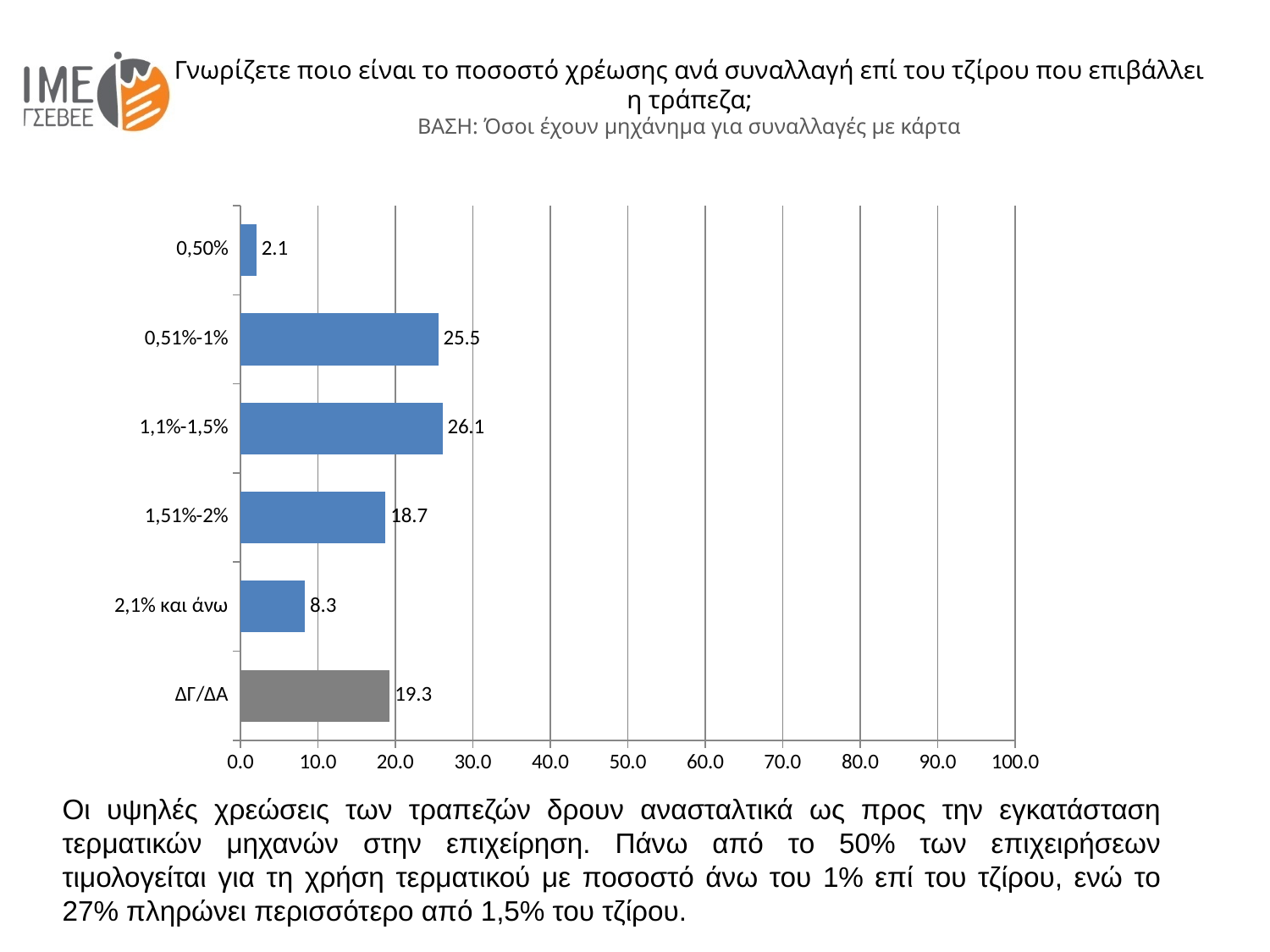
What is the value for the category "ΔΓ/ΔΑ"? 19.3 How many categories are shown in the chart? 6 Which category has the lowest value? 0,50% What is the difference between the values for "1,1%-1,5%" and "1,51%-2%"? 7.4 What is the value for the category "0,51%-1%"? 25.5 What is the maximum value shown on the horizontal axis? 100.0 What kind of chart is shown on the slide? Bar chart Which category has the highest value? 1,1%-1,5% What is the value for the category "2,1% και άνω"? 8.3 Is the value for "0,51%-1%" greater or less than 20.0? greater Which is larger, the value for "1,51%-2%" or the value for "ΔΓ/ΔΑ"? ΔΓ/ΔΑ Which category's bar is coloured grey rather than blue? ΔΓ/ΔΑ